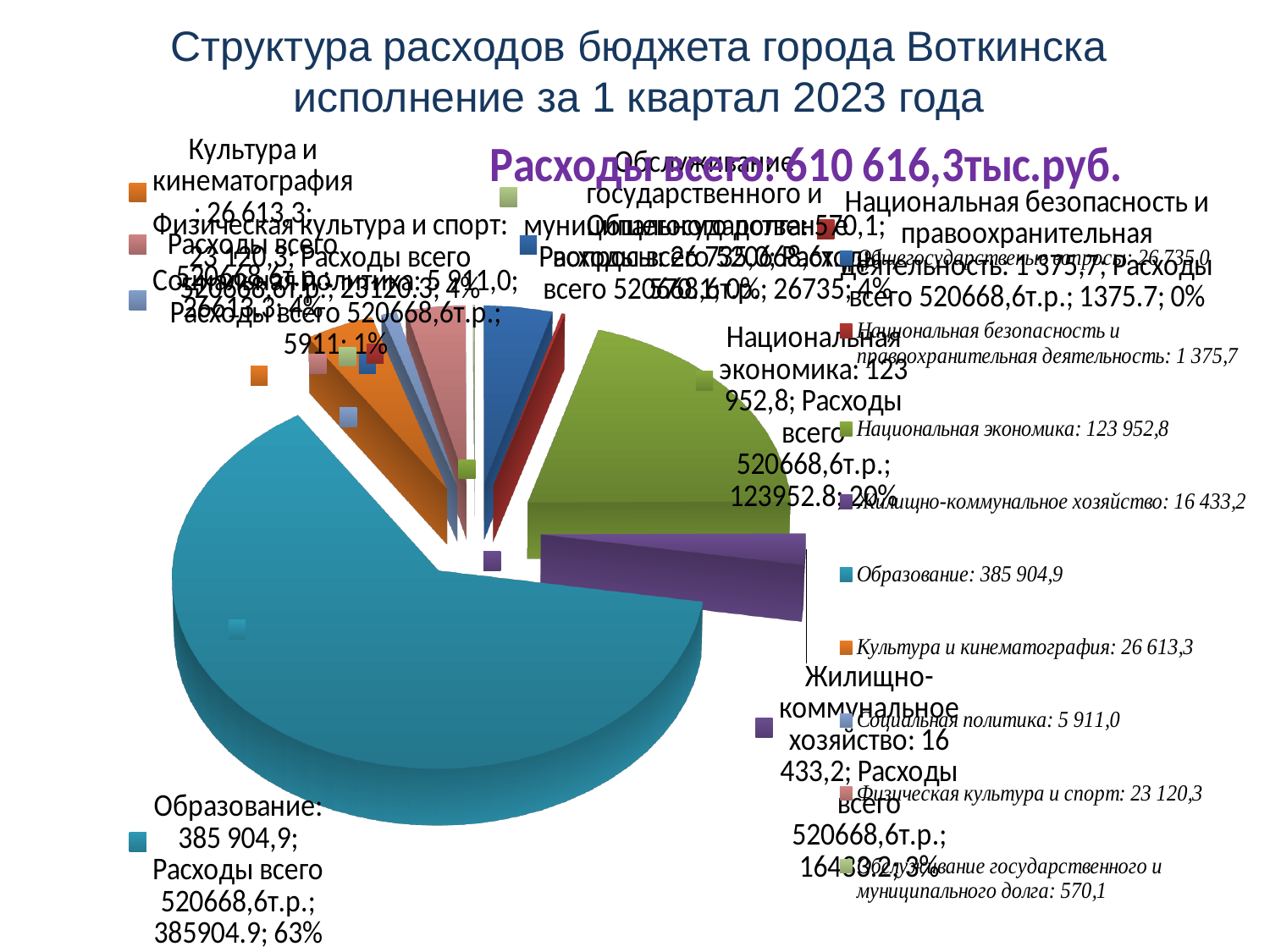
How many categories does the legend list? 9 What is the difference between the values for Образование and Национальная экономика? 261 952,1 What kind of chart is shown on the slide? pie chart What is the value for Образование? 385 904,9 Which category has the smallest value? Обслуживание государственного и муниципального долга What is the value for Жилищно-коммунальное хозяйство? 16 433,2 What share of the pie does Образование take? 63% What is the value for Национальная экономика? 123 952,8 Which category has the largest slice of the pie? Образование Which is larger, Физическая культура и спорт or Социальная политика? Физическая культура и спорт What share of the pie does Национальная экономика take? 20% What is the value for Обслуживание государственного и муниципального долга? 570,1